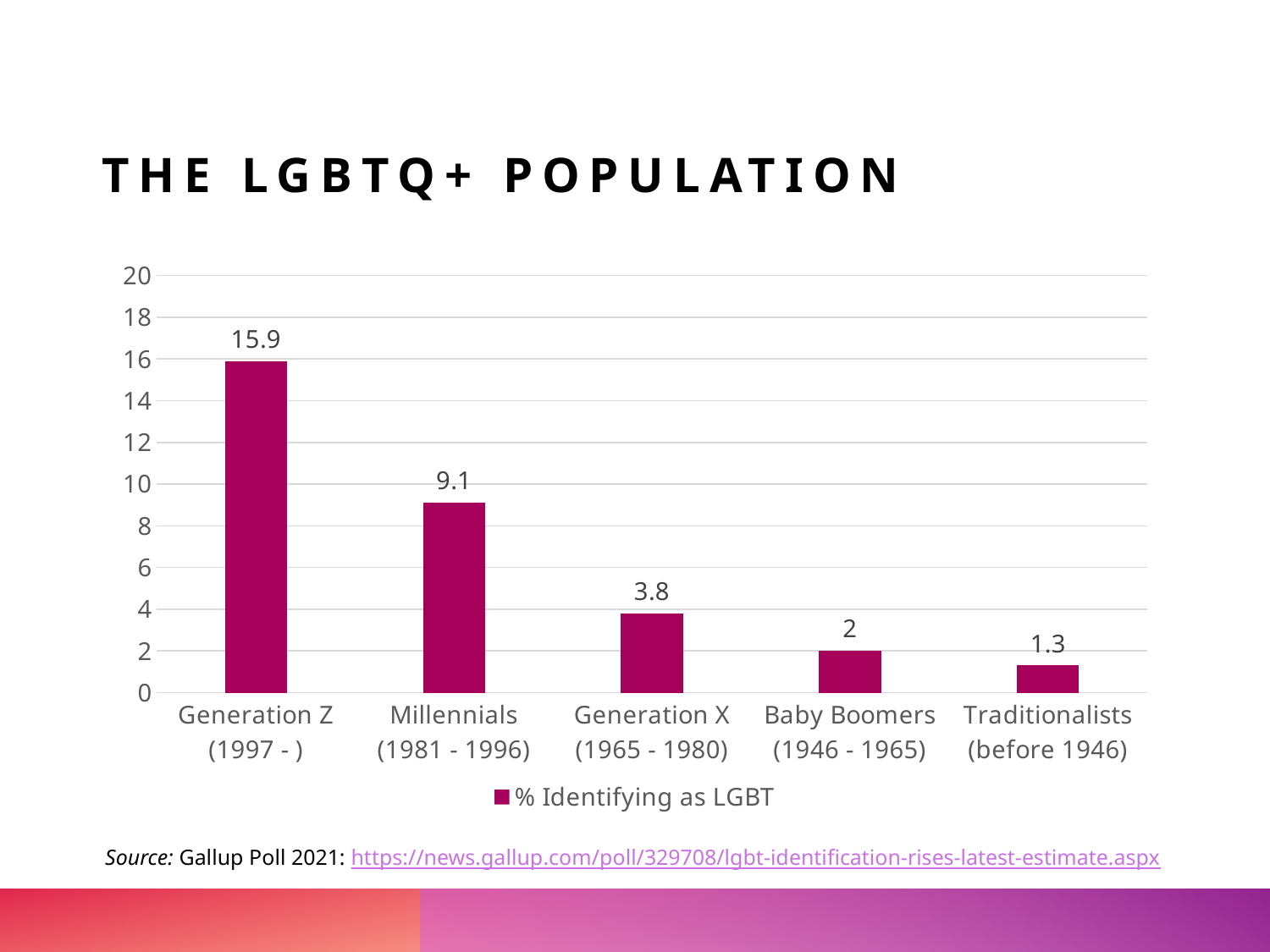
Which generation has the lowest value? Traditionalists (before 1946) What is the value for Baby Boomers (1946 - 1965)? 2 How many generations are shown on the chart? 5 Which is larger, the value for Generation X or the value for Baby Boomers? Generation X What is the value for Traditionalists (before 1946)? 1.3 What is the difference between the values for Generation Z and Millennials? 6.8 What is the value for Generation Z (1997 - )? 15.9 What kind of chart is shown on the slide? Bar chart Do the values rise or fall from Generation Z to Traditionalists along the x axis? Fall How many series does the legend list? 1 Which generation has the highest value? Generation Z (1997 - ) What is the value for Millennials (1981 - 1996)? 9.1